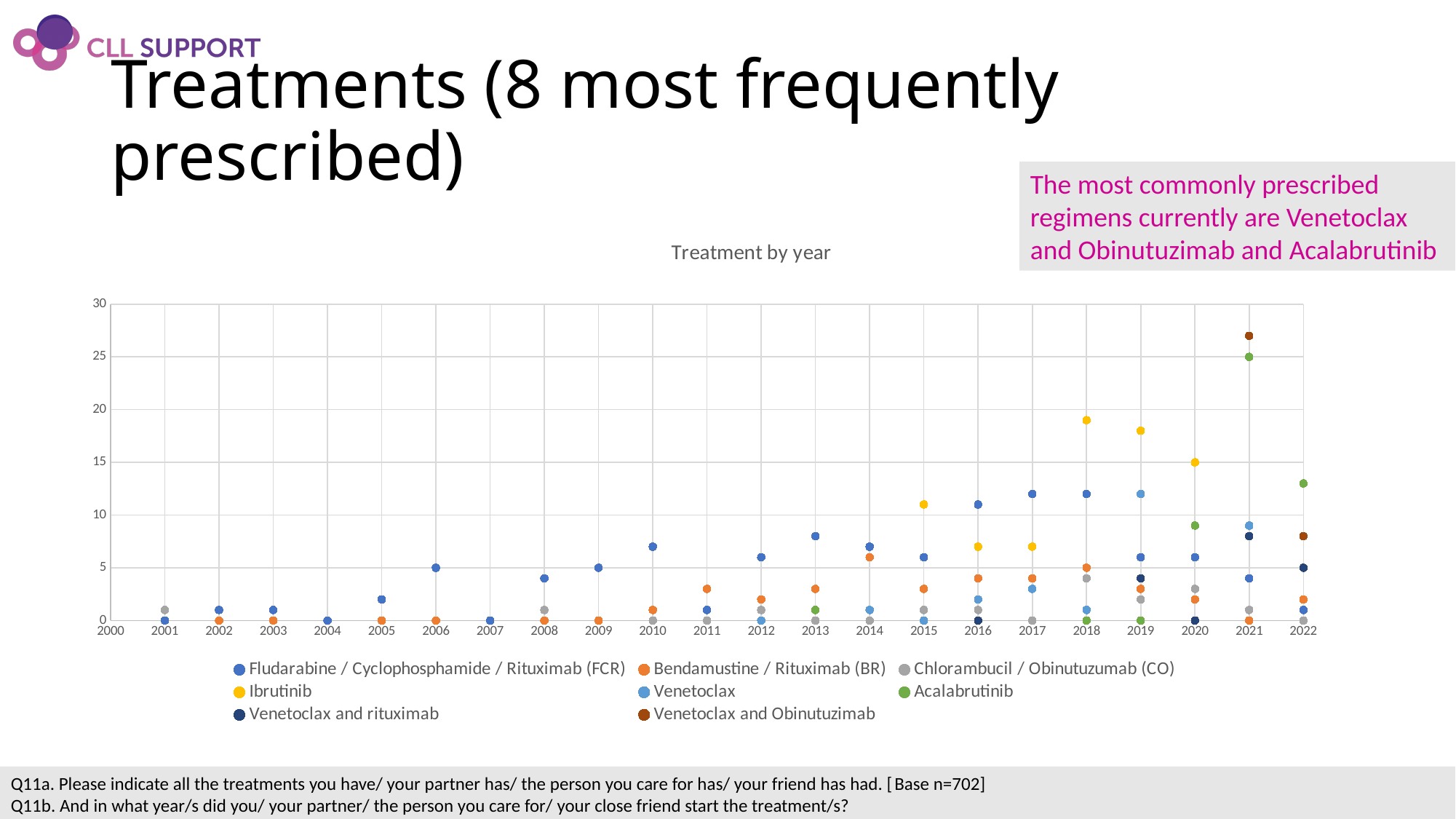
Do the values for Ibrutinib rise or fall from 2018 to 2020? fall Is the value for Venetoclax and Obinutuzimab in 2021 greater or less than 25? greater What is the value for Ibrutinib in 2020? 15 Is the value for Ibrutinib in 2018 greater or less than 15? greater How many series does the chart legend list? 8 What is the value for Acalabrutinib in 2021? 25 Is the value for Acalabrutinib in 2022 greater or less than 10? greater In 2018, which is larger: the value for Ibrutinib or the value for Fludarabine / Cyclophosphamide / Rituximab (FCR)? Ibrutinib What is the title of the chart? Treatment by year Which treatment has the highest point on the chart, and in which year? Venetoclax and Obinutuzimab, 2021 What kind of chart is shown on the slide? scatter chart